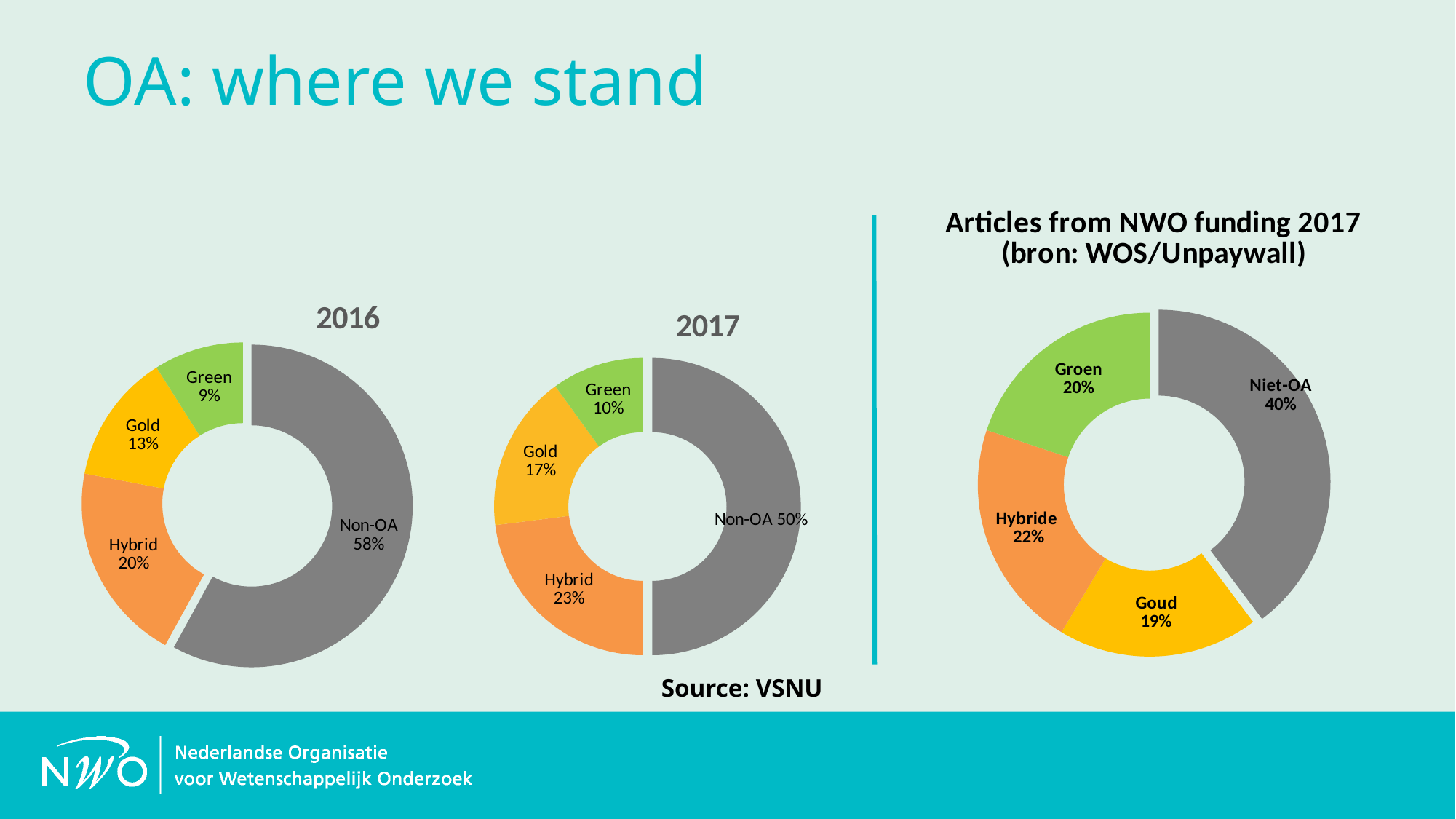
What is the difference between the Gold share in 2017 and the Gold share in 2016? 4% In the 2016 chart, what share is Non-OA? 58% In the 'Articles from NWO funding 2017' chart, what share is Goud? 19% In the 'Articles from NWO funding 2017' chart, which category has the largest share? Niet-OA What source is cited for the 2016 and 2017 charts? VSNU What kind of chart is the 2016 chart? Doughnut chart In the 2017 chart, what share is Hybrid? 23% What is the title of the chart on the right of the slide? Articles from NWO funding 2017 (bron: WOS/Unpaywall) In the 2016 chart, which category has the smallest share? Green How many categories does the 2017 chart show? 4 In the 2016 chart, what is the combined share of Gold and Green? 22% In the 'Articles from NWO funding 2017' chart, which is larger, Hybride or Groen? Hybride